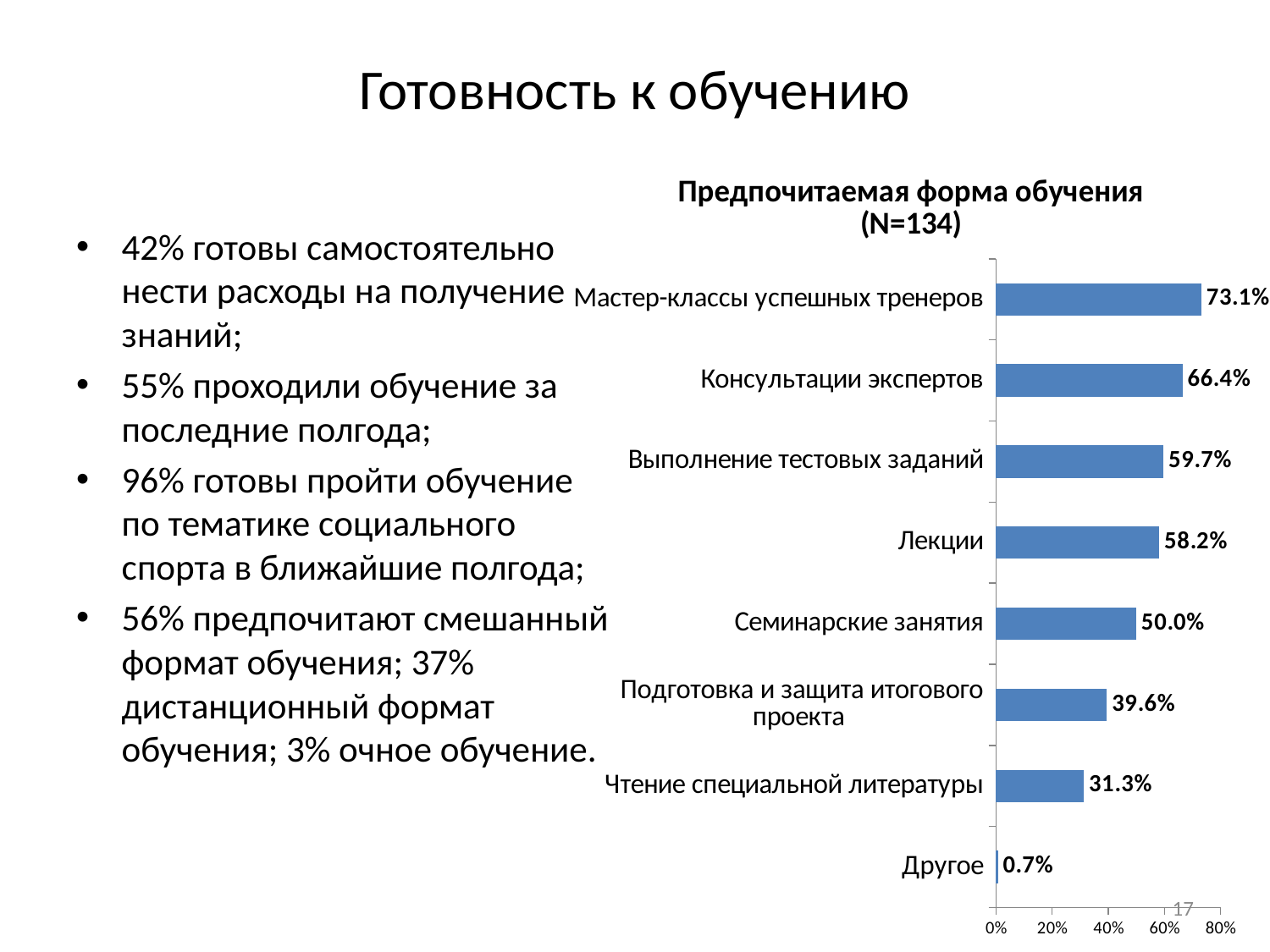
What is the value for Мастер-классы успешных тренеров? 73.1% Which category has the lowest value? Другое What is the title of the chart? Предпочитаемая форма обучения (N=134) What is the difference between Консультации экспертов and Семинарские занятия? 16.4% What is the value for Чтение специальной литературы? 31.3% Is the value for Подготовка и защита итогового проекта greater or less than 40%? less Which is larger: Выполнение тестовых заданий or Подготовка и защита итогового проекта? Выполнение тестовых заданий What kind of chart is shown on the slide? bar chart How many categories are shown in the chart? 8 Which category has the highest value? Мастер-классы успешных тренеров What is the sample size (N) stated in the chart title? 134 What is the value for Лекции? 58.2%